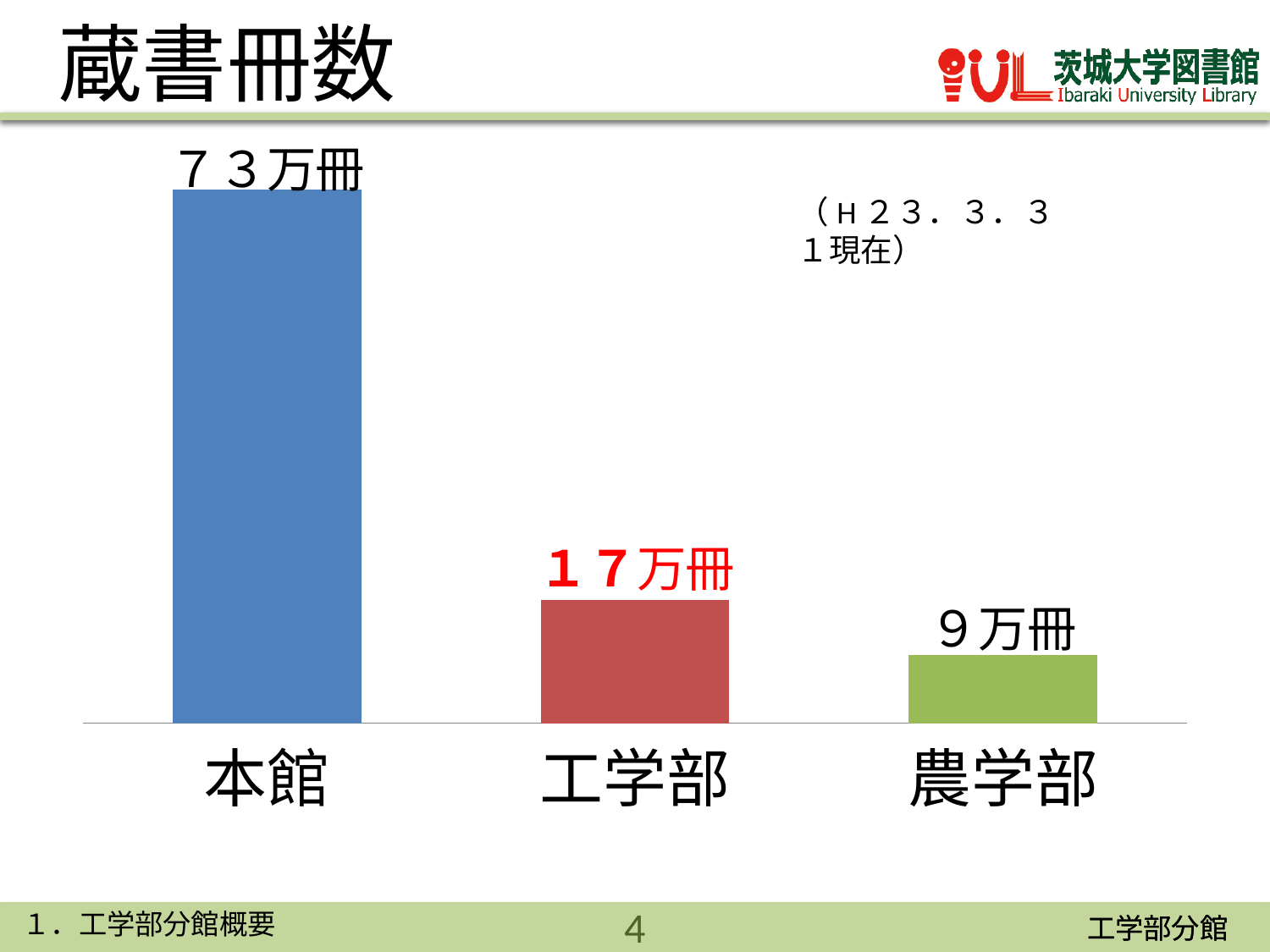
Which category has the highest value? 本館 Which category has the lowest value? 農学部 What kind of chart is shown on the slide? Bar chart What colour is the bar for 工学部? Red What is the value for 本館? ７３万冊 What is the difference between the values for 工学部 and 農学部? ８万冊 What is the value for 工学部? １７万冊 Which is larger, the value for 工学部 or the value for 農学部? 工学部 What is the value for 農学部? ９万冊 How many categories are shown in the chart? 3 What is the title of the chart? 蔵書冊数 What is the difference between the values for 本館 and 工学部? ５６万冊